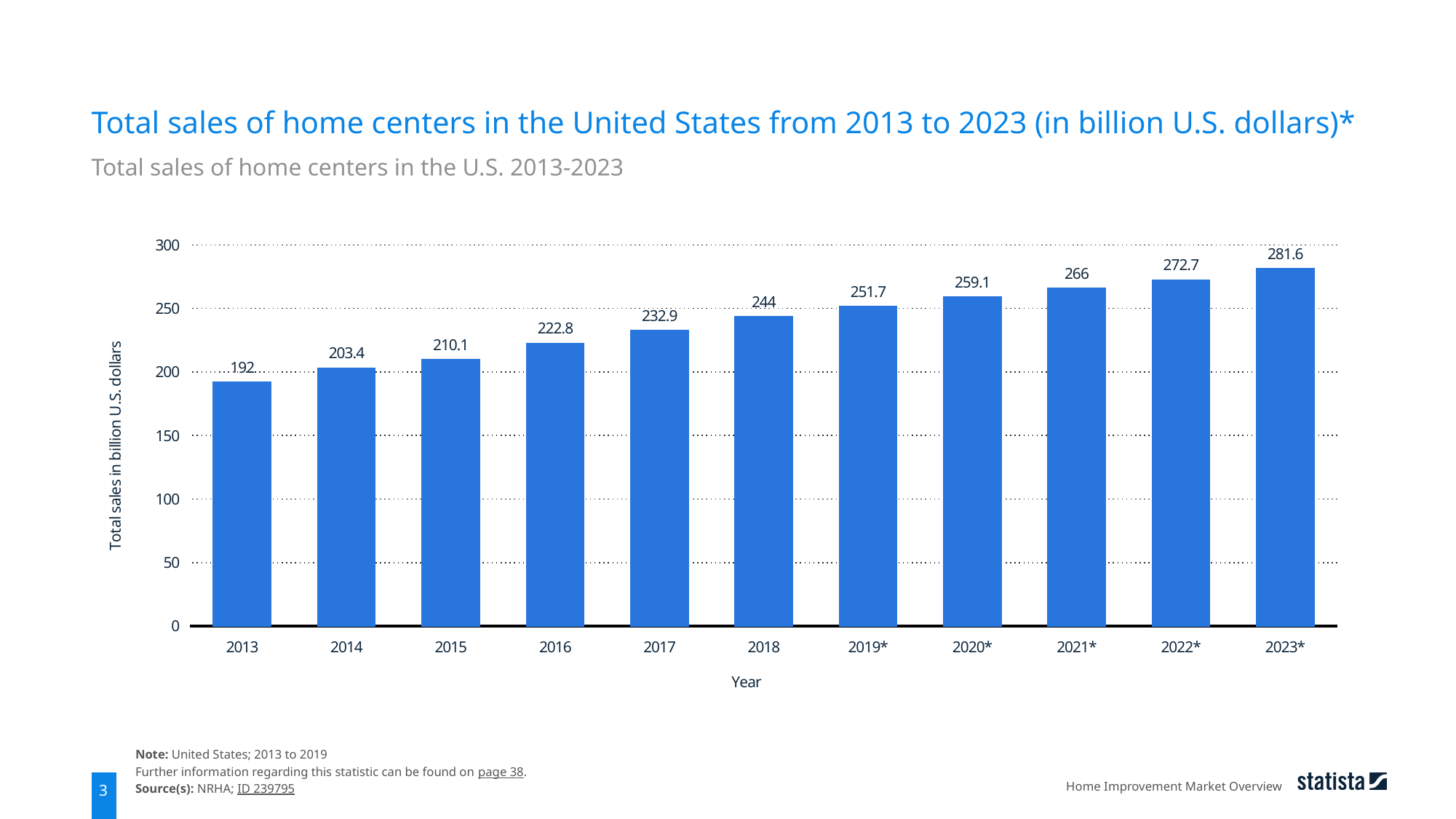
What is the total sales value for 2018? 244 How many years are shown on the x axis? 11 Which year has the lowest total sales? 2013 What is the difference between the total sales in 2023* and 2013? 89.6 Is the value for 2020* greater or less than 250? greater Which year has the highest total sales? 2023* Which is larger, the total sales in 2015 or in 2019*? 2019* What kind of chart is shown on the slide? Bar chart Do the total sales values rise or fall from 2013 to 2023*? Rise What is the difference between the total sales in 2017 and 2016? 10.1 What is the total sales value for 2013? 192 What is the total sales value for 2021*? 266